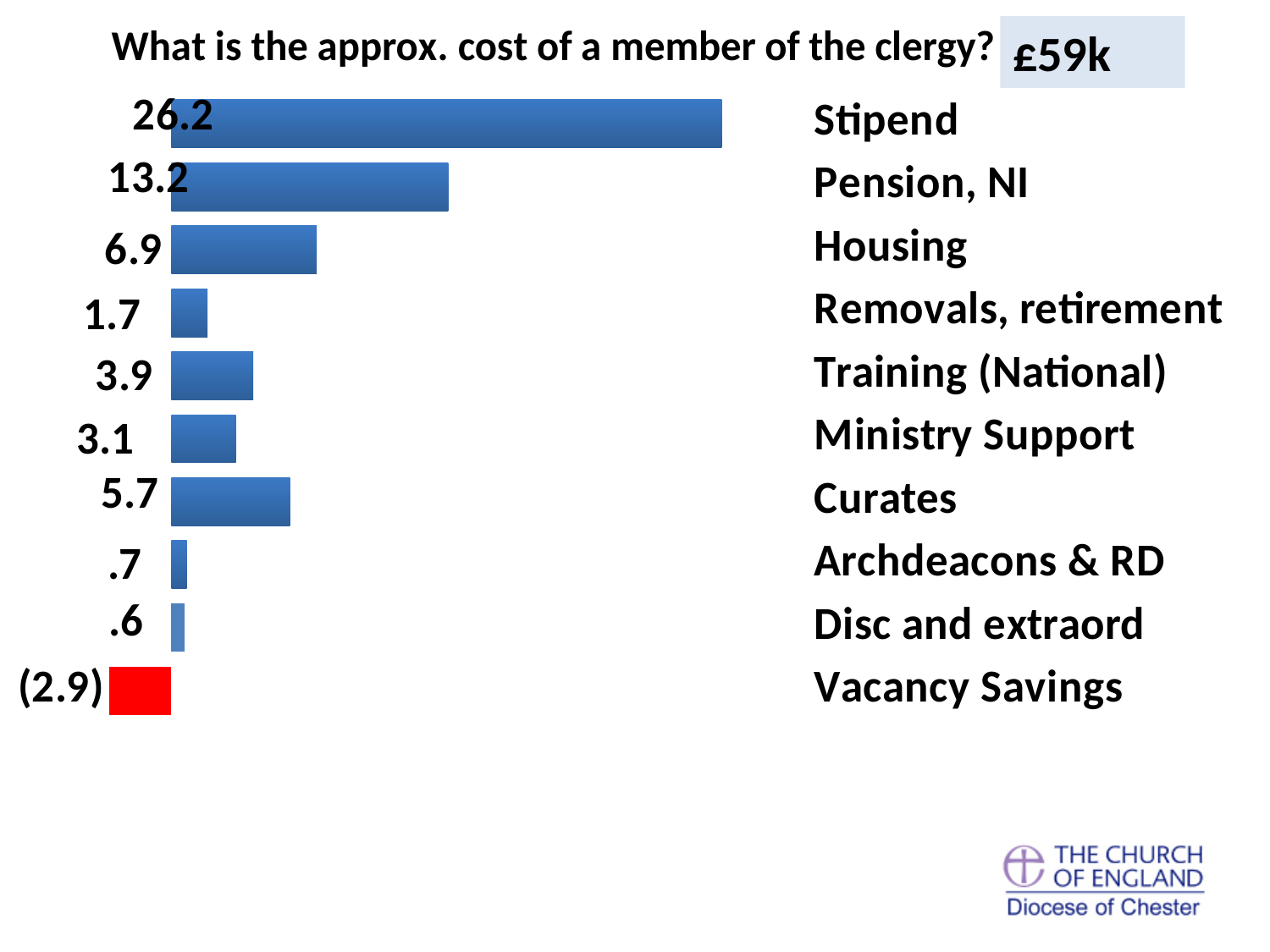
Which category has the smallest positive value? Disc and extraord What is the value shown for Pension, NI? 13.2 What kind of chart is shown on the slide? Bar chart What is the value shown for Stipend? 26.2 What is the difference between the values for Stipend and Pension, NI? 13.0 Which is larger, the value for Training (National) or the value for Ministry Support? Training (National) What is the value shown for Vacancy Savings? (2.9) Which category's bar is coloured red? Vacancy Savings What is the value shown for Curates? 5.7 What is the difference between the values for Housing and Curates? 1.2 How many categories are shown in the chart? 10 Which category has the largest bar? Stipend